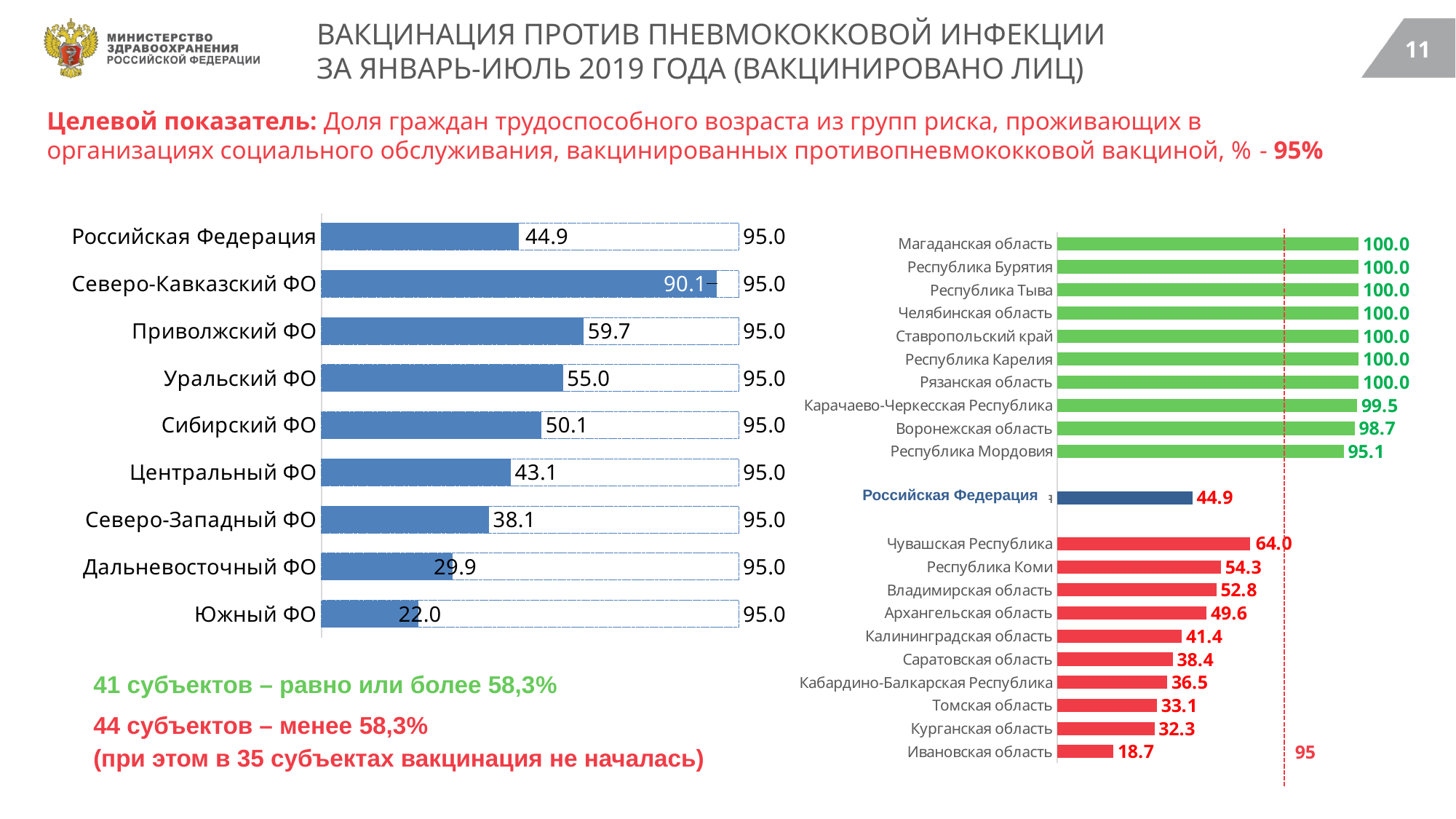
In the right chart of regions, which region has the lowest value? Ивановская область In the right chart of regions, which is larger: the value for Республика Коми or the value for Владимирская область? Республика Коми What type of chart is the left chart of federal districts? bar chart In the left chart of federal districts, what is the value for Приволжский ФО? 59.7 In the left chart of federal districts, how many categories are plotted? 9 In the right chart of regions, what is the difference between the value for Чувашская Республика and the value for Российская Федерация? 19.1 In the left chart of federal districts, what is the difference between the value for Уральский ФО and the value for Сибирский ФО? 4.9 In the right chart of regions, what is the value for Воронежская область? 98.7 In the left chart of federal districts, which category has the lowest value? Южный ФО In the left chart of federal districts, what target value is shown next to each bar? 95.0 In the left chart of federal districts, which federal district has the highest value? Северо-Кавказский ФО In the right chart of regions, how many regions have a value of 100.0? 7